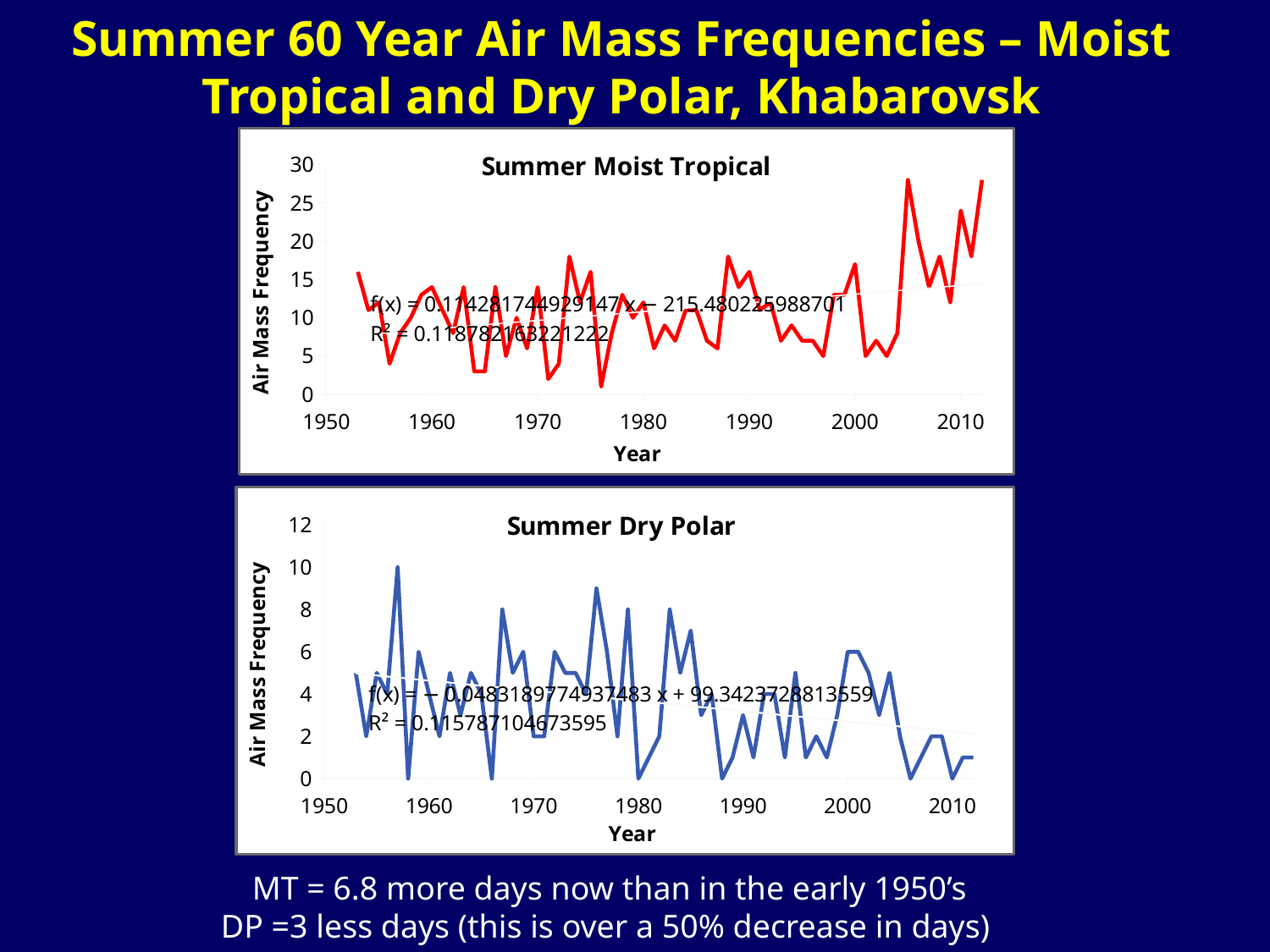
What kind of chart is the Summer Moist Tropical chart? line chart In the Summer Moist Tropical chart, does the fitted trend line rise or fall from 1950 to 2010? rise In the Summer Dry Polar chart, is the peak value around 1957 greater or less than 8? greater What colour is the data line in the Summer Moist Tropical chart? red In the Summer Dry Polar chart, does the fitted trend line rise or fall from 1950 to 2010? fall In the Summer Moist Tropical chart, is the lowest value around 1976 greater or less than 5? less In the Summer Dry Polar chart, is the value around 2010 greater or less than 4? less What kind of chart is the Summer Dry Polar chart? line chart What is the label of the y axis on the Summer Dry Polar chart? Air Mass Frequency How many charts are shown on the slide? 2